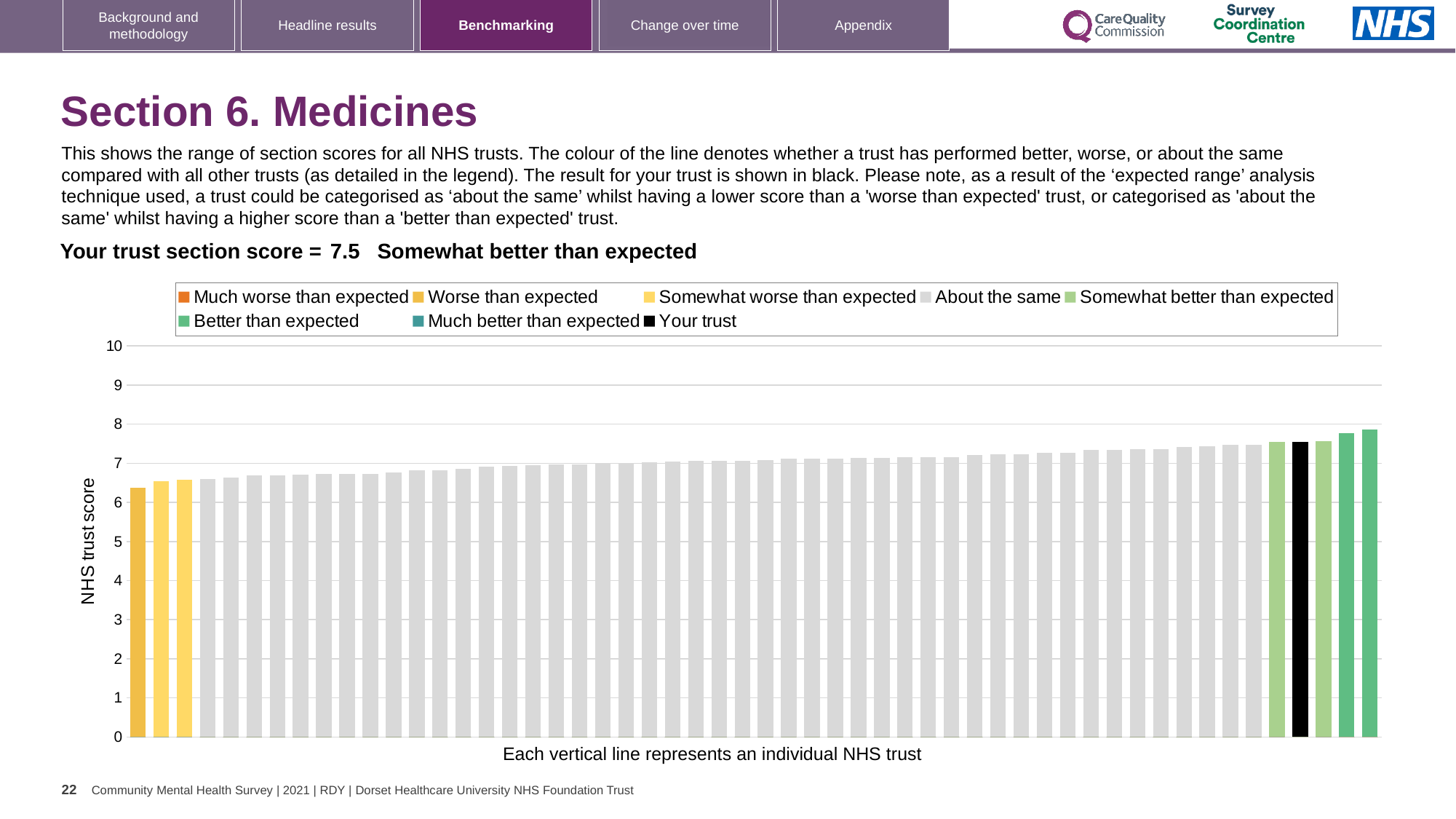
Is the value of the rightmost bar greater or less than 7? greater Which is higher: the rightmost bar or the black bar for your trust? The rightmost bar Is the value for your trust's bar greater or less than 7? greater How many entries does the chart legend list? 8 Do the bar values rise or fall from left to right along the x axis? Rise What kind of chart is shown on the slide? Bar chart What is the section score for your trust shown on the slide? 7.5 How many bars in the chart are coloured black? 1 Which legend category does your trust fall into according to the slide? Somewhat better than expected Is your trust's bar higher or lower than the leftmost bar? Higher What is the label on the vertical axis of the chart? NHS trust score Is the value of the leftmost (lowest) bar greater or less than 7? less